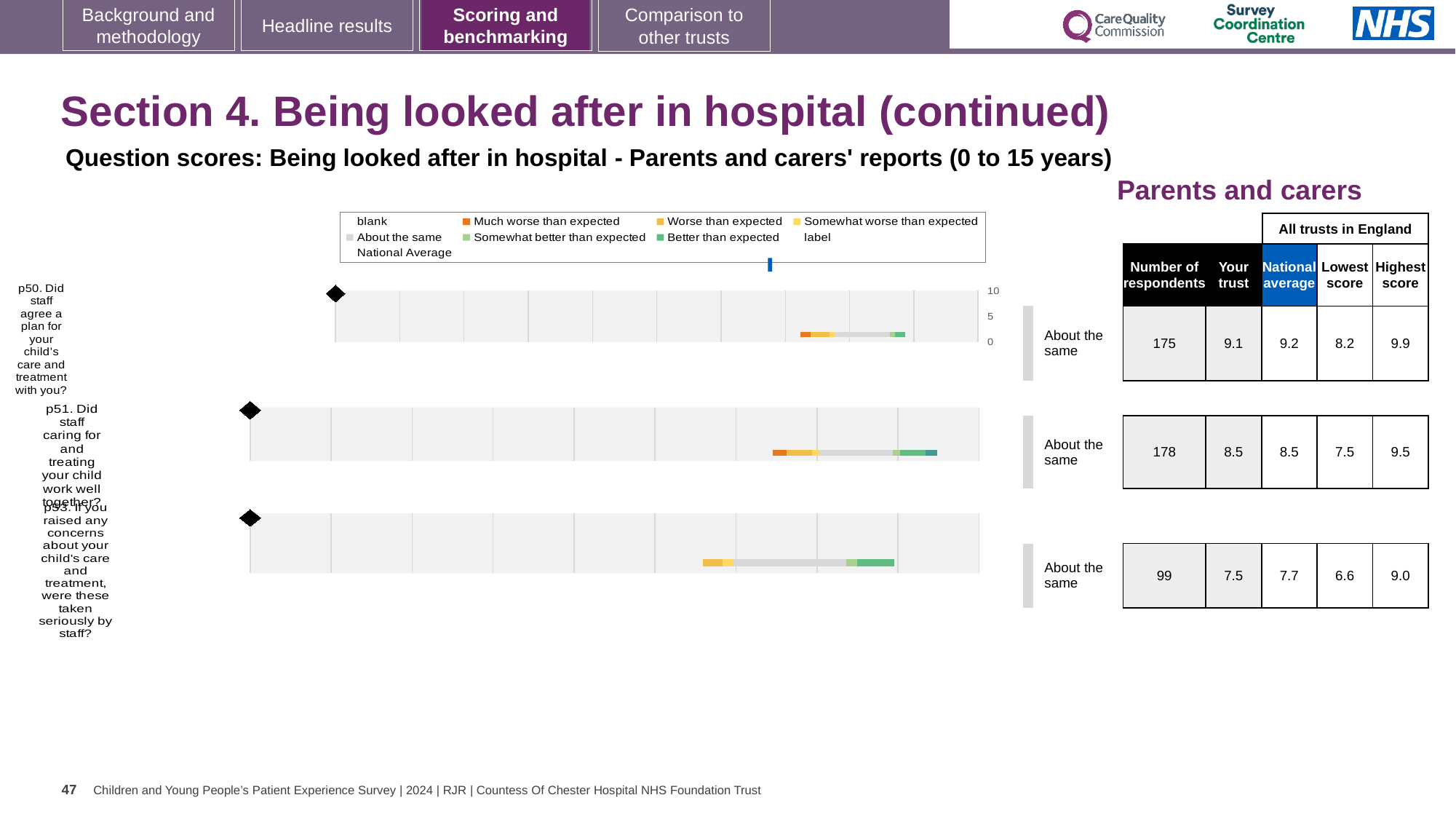
In the table, what is the 'Your trust' score for p50 (Did staff agree a plan for your child's care and treatment with you)? 9.1 In the table, what is the Highest score for p50? 9.9 What kind of chart is used to show the benchmark bands for questions p50, p51 and p53? bar chart Which of the three questions has the lowest 'Your trust' score in the table? p53 In the table, is the 'Your trust' score for p53 higher or lower than the National average for p53? lower How many entries does the legend above the charts list? 9 In the table, how many respondents answered p53 (If you raised any concerns about your child's care and treatment, were these taken seriously by staff)? 99 How many question charts (p50, p51, p53) are shown on the slide? 3 What benchmark category is shown next to each of the three charts? About the same In the table, what is the difference between the Highest score and the Lowest score for p53? 2.4 What is the highest tick value shown on the axis to the right of the p50 chart? 10 In the table, what is the National average for p51 (Did staff caring for and treating your child work well together)? 8.5